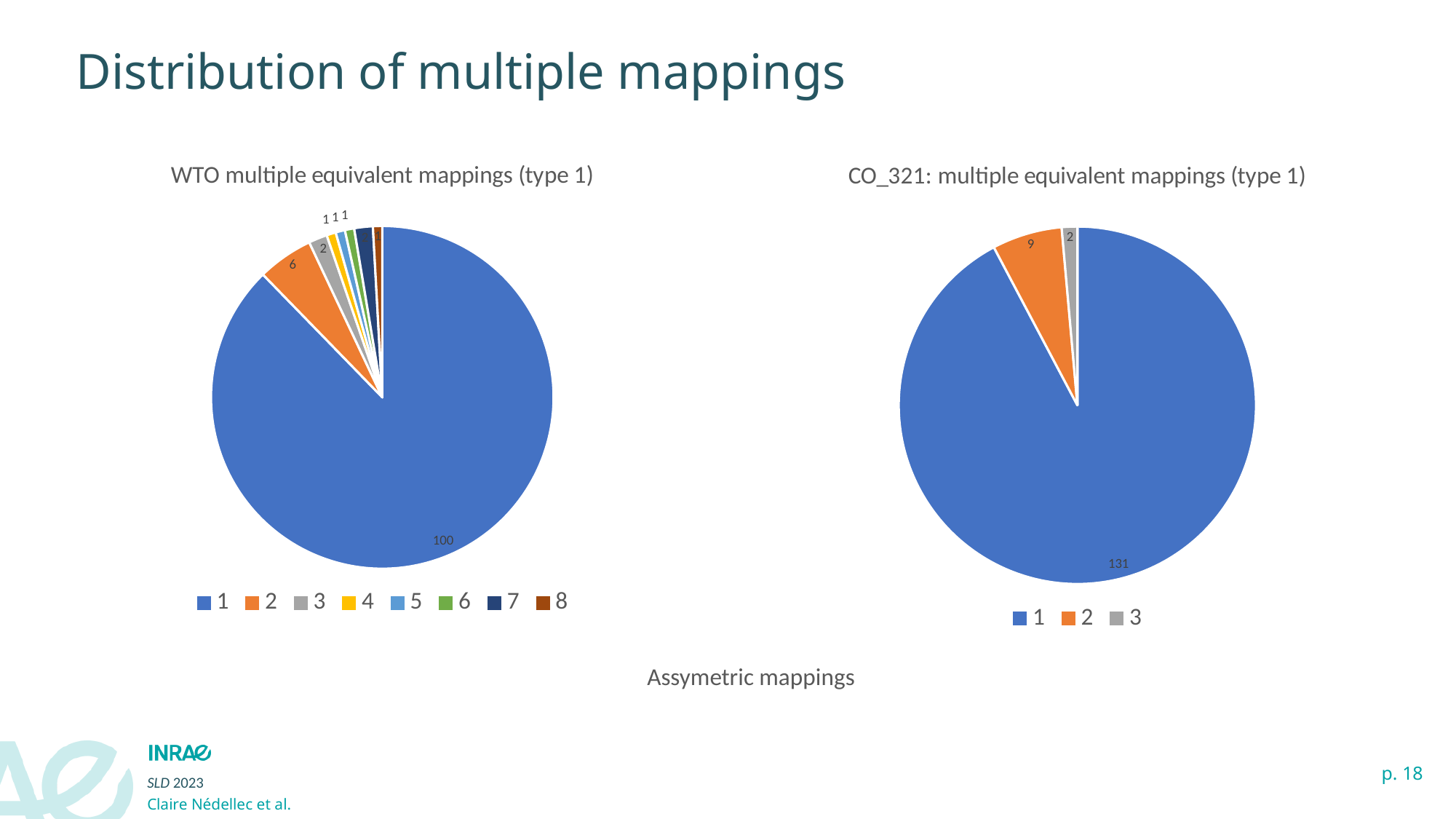
How many categories does the legend of the WTO multiple equivalent mappings (type 1) chart list? 8 In the WTO multiple equivalent mappings (type 1) chart, what is the value for category 3? 2 What kind of chart is the WTO multiple equivalent mappings (type 1) chart on the left? Pie chart In the CO_321: multiple equivalent mappings (type 1) chart, what is the value for category 2? 9 In the WTO multiple equivalent mappings (type 1) chart, which category has the largest slice? 1 In the WTO multiple equivalent mappings (type 1) chart, what is the difference between the values for category 1 and category 2? 94 In the WTO multiple equivalent mappings (type 1) chart, what is the value for category 1? 100 How many categories does the legend of the CO_321: multiple equivalent mappings (type 1) chart list? 3 In the CO_321: multiple equivalent mappings (type 1) chart, which category has the smallest slice? 3 In the CO_321: multiple equivalent mappings (type 1) chart, what is the value for category 1? 131 In the CO_321: multiple equivalent mappings (type 1) chart, what is the difference between the values for category 1 and category 2? 122 In the WTO multiple equivalent mappings (type 1) chart, what is the value for category 2? 6